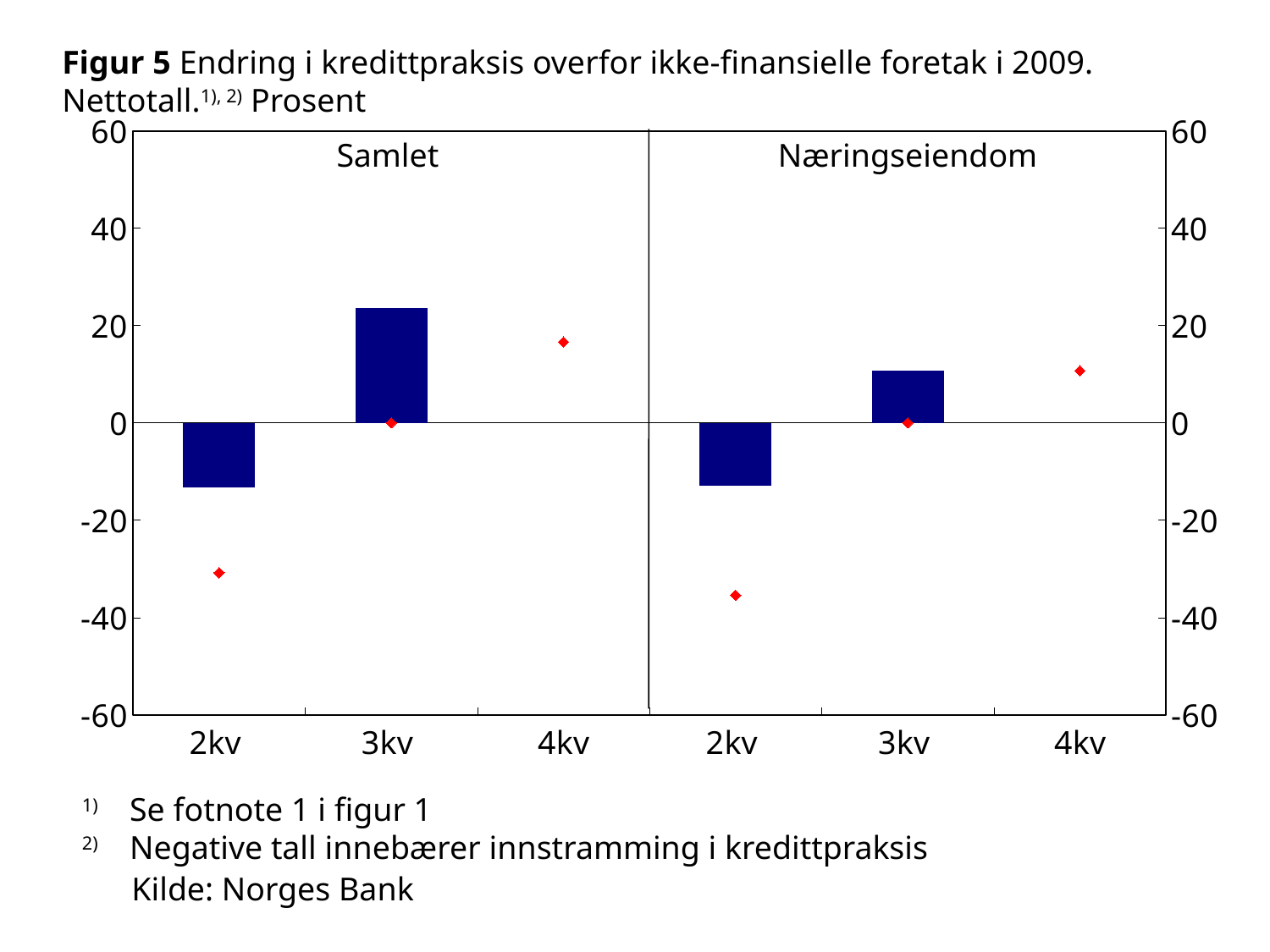
In the Næringseiendom panel, is the bar for 3kv greater or less than 20? less In the Næringseiendom panel, is the red marker for 2kv greater or less than -20? less In the Samlet panel, is the red marker for 4kv greater or less than 0? greater How many quarters are shown on the x axis of the Samlet panel? 3 What are the titles of the two panels in the chart? Samlet and Næringseiendom In the Næringseiendom panel, do the red markers rise or fall from 2kv to 4kv? rise Which is larger, the 3kv bar in the Samlet panel or the 3kv bar in the Næringseiendom panel? Samlet In the Samlet panel, which bar is higher, 2kv or 3kv? 3kv What kind of chart is shown on the slide? combination chart with bars and red diamond markers